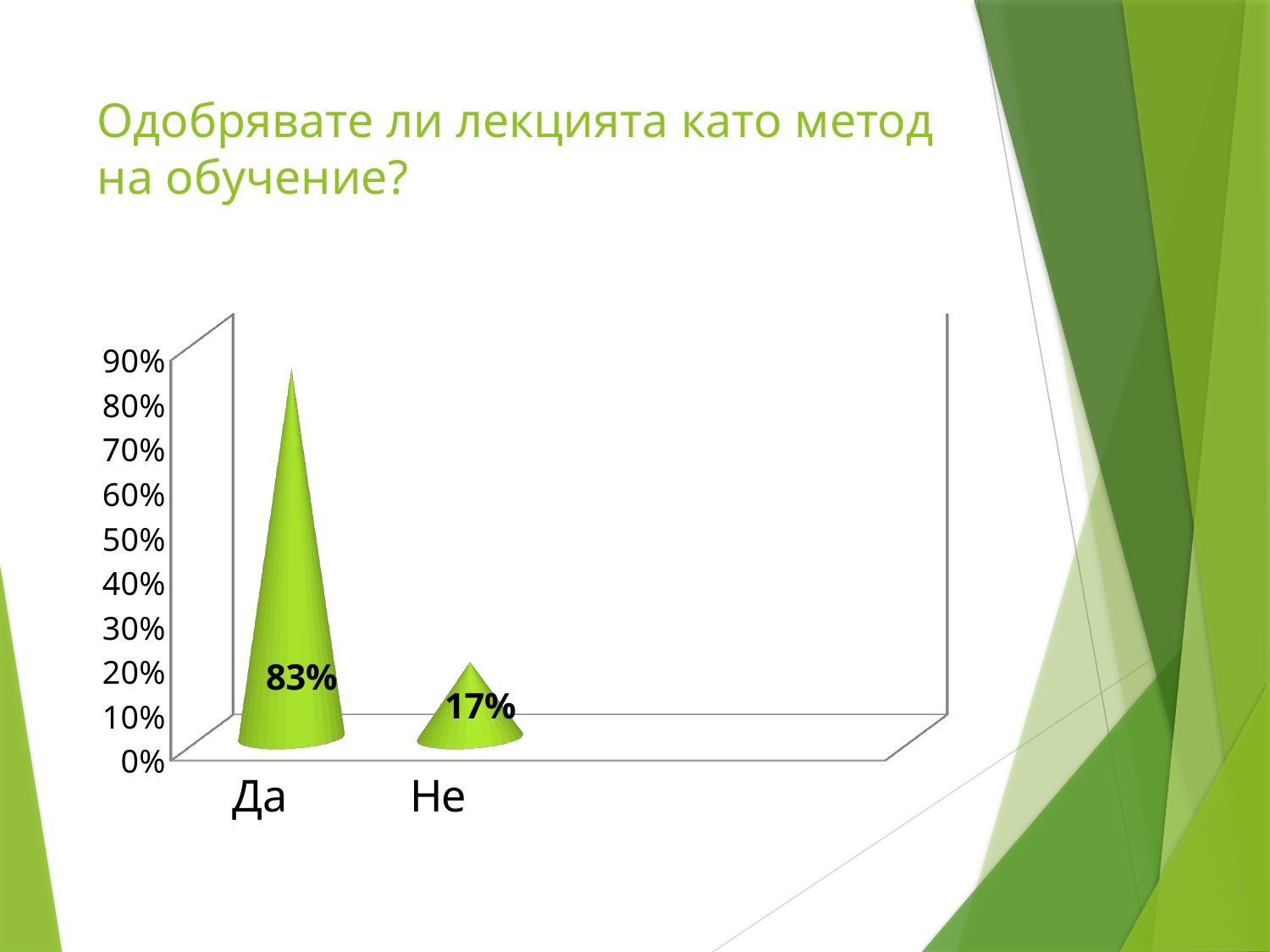
Is the value for Да greater or less than 50%? greater What is the total of the two values shown? 100% What kind of chart is shown on the slide? bar chart What is the difference between the values for Да and Не? 66% Is the value for Не greater or less than 30%? less Which category has the highest value? Да What is the title of the slide? Одобрявате ли лекцията като метод на обучение? Which category has the lowest value? Не How many categories are shown on the x axis? 2 Which is larger, the value for Да or the value for Не? Да What is the value for Не? 17% What is the value for Да? 83%